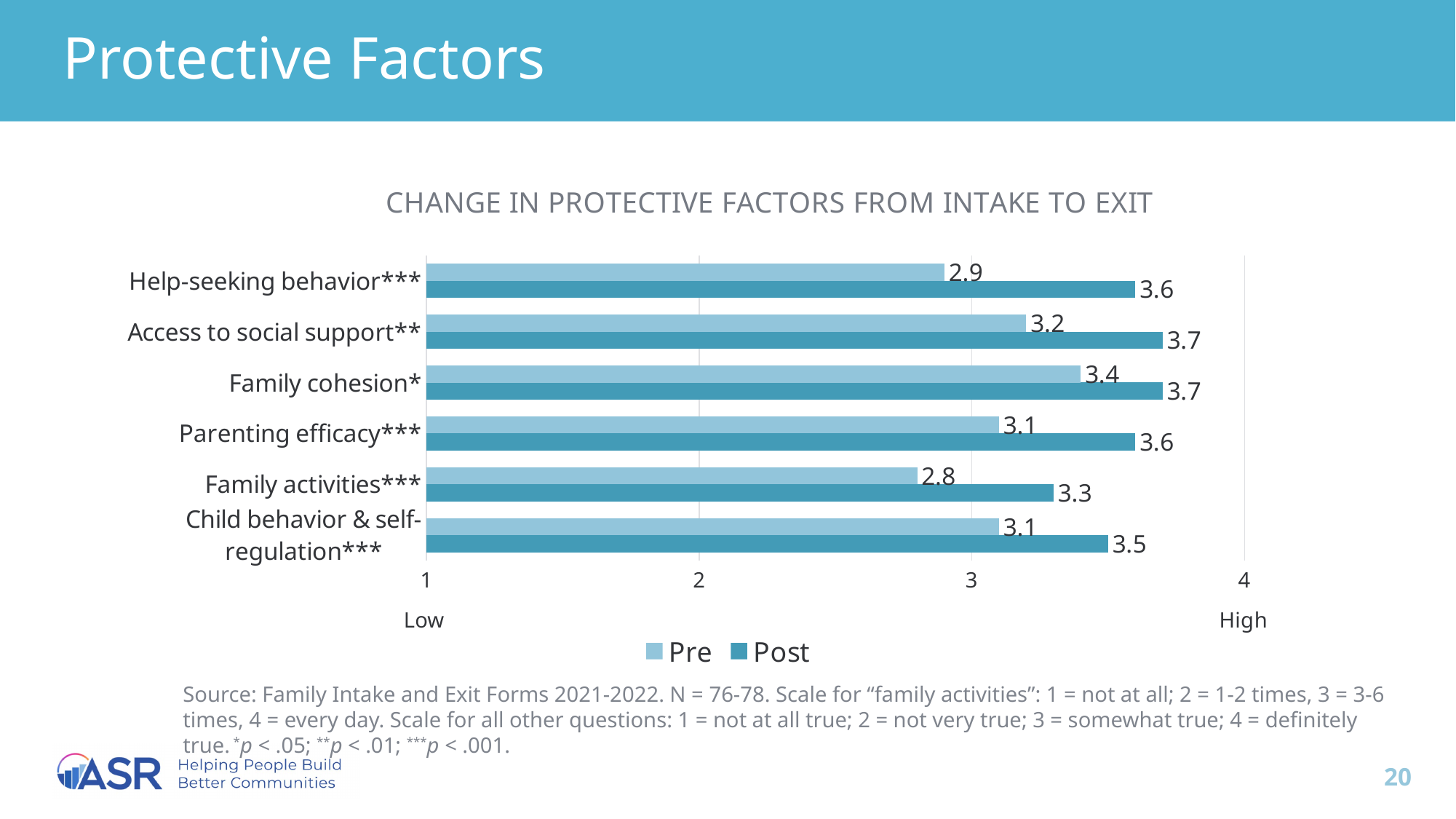
Which is larger, the Pre value for Access to social support** or the Pre value for Family cohesion*? Family cohesion* Which category has the highest Pre value? Family cohesion* What is the Post value for Child behavior & self-regulation***? 3.5 Which category has the lowest Post value? Family activities*** What is the Pre value for Help-seeking behavior***? 2.9 How many series does the legend list? 2 What kind of chart is shown on the slide? Bar chart Which category has the lowest Pre value? Family activities*** What is the title of the chart? CHANGE IN PROTECTIVE FACTORS FROM INTAKE TO EXIT What is the Post value for Family activities***? 3.3 How many categories are shown on the chart? 6 What is the difference between the Post and Pre values for Help-seeking behavior***? 0.7